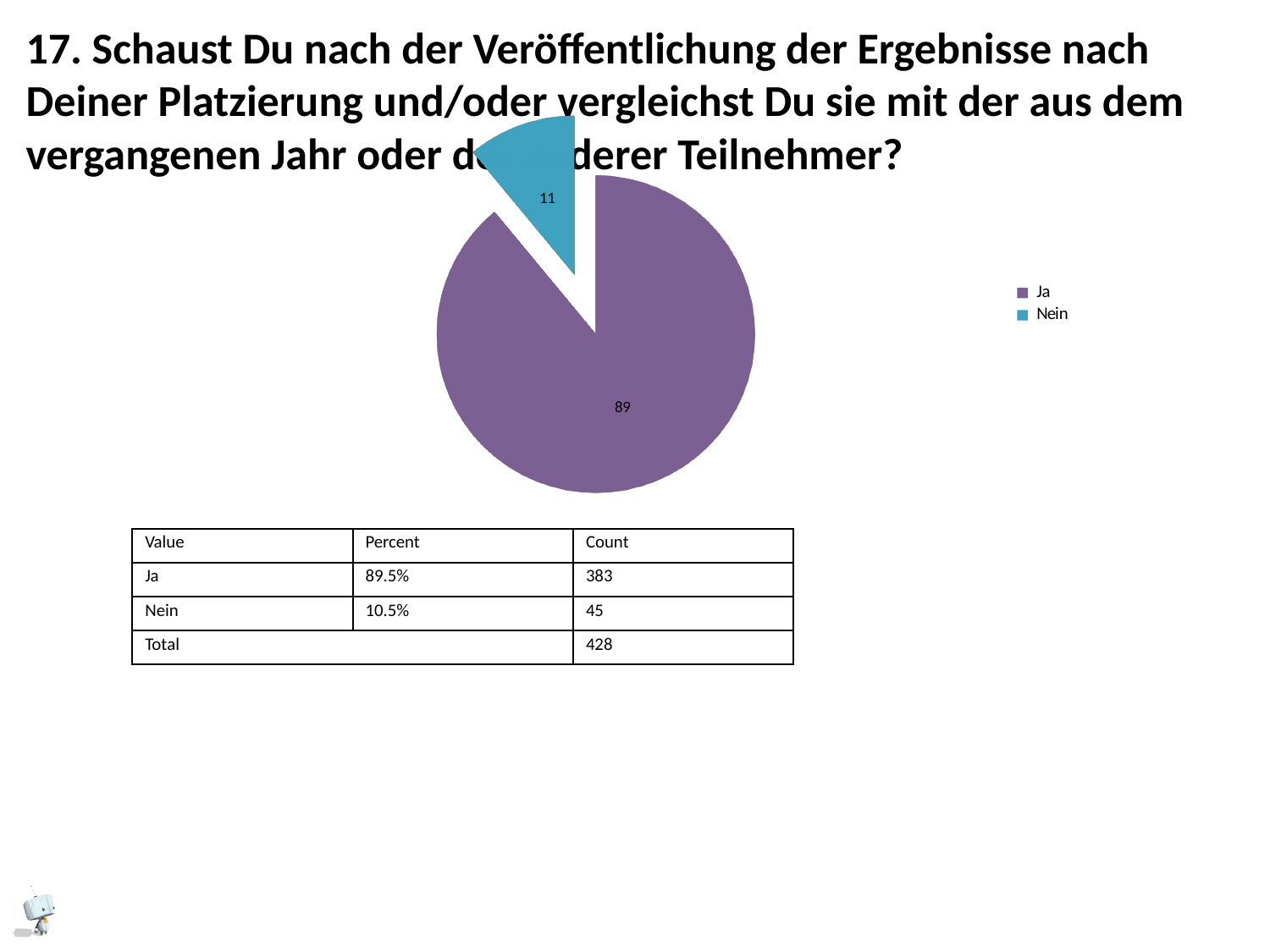
Which legend entry of the pie chart is shown in purple? Ja How many slices does the pie chart have? 2 What value is printed on the 'Nein' slice of the pie chart? 11 What are the two legend entries of the pie chart? Ja, Nein How many entries does the legend of the pie chart list? 2 What value is printed on the 'Ja' slice of the pie chart? 89 Which slice of the pie chart is the largest? Ja Which slice is larger in the pie chart, 'Ja' or 'Nein'? Ja What is the difference between the values printed on the 'Ja' and 'Nein' slices of the pie chart? 78 What kind of chart is shown on the slide? pie chart Which slice of the pie chart is the smallest? Nein